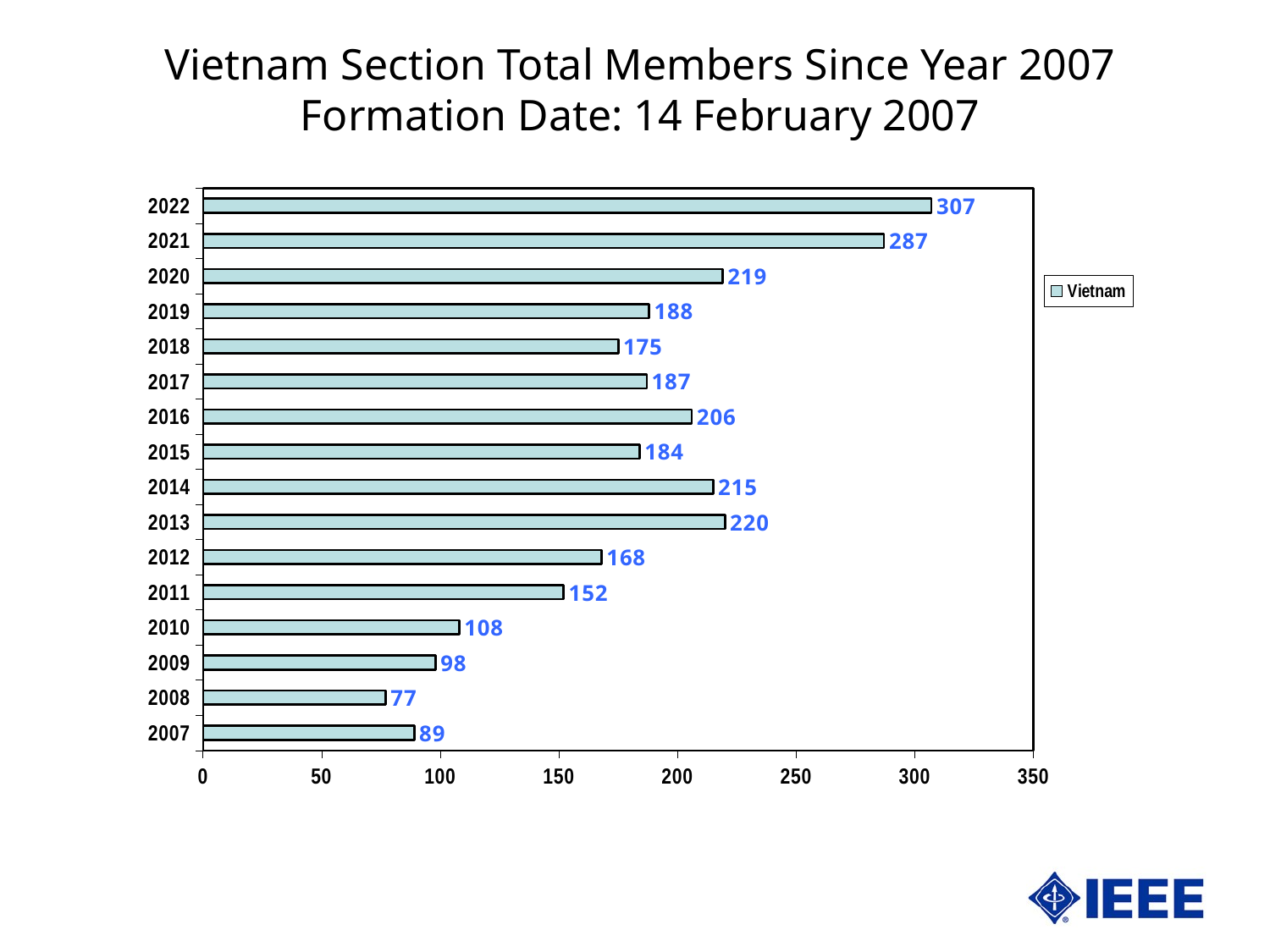
Is the value for 2011 greater or less than 150? greater Which year has the lowest value? 2008 What is the value for 2022? 307 What kind of chart is shown on the slide? bar chart What is the value for 2008? 77 Which is larger, the value for 2016 or the value for 2015? 2016 What is the difference between the values for 2022 and 2021? 20 What is the only entry listed in the legend? Vietnam How many years are shown on the chart? 16 What is the difference between the values for 2010 and 2009? 10 What is the value for 2013? 220 Which year has the highest value? 2022